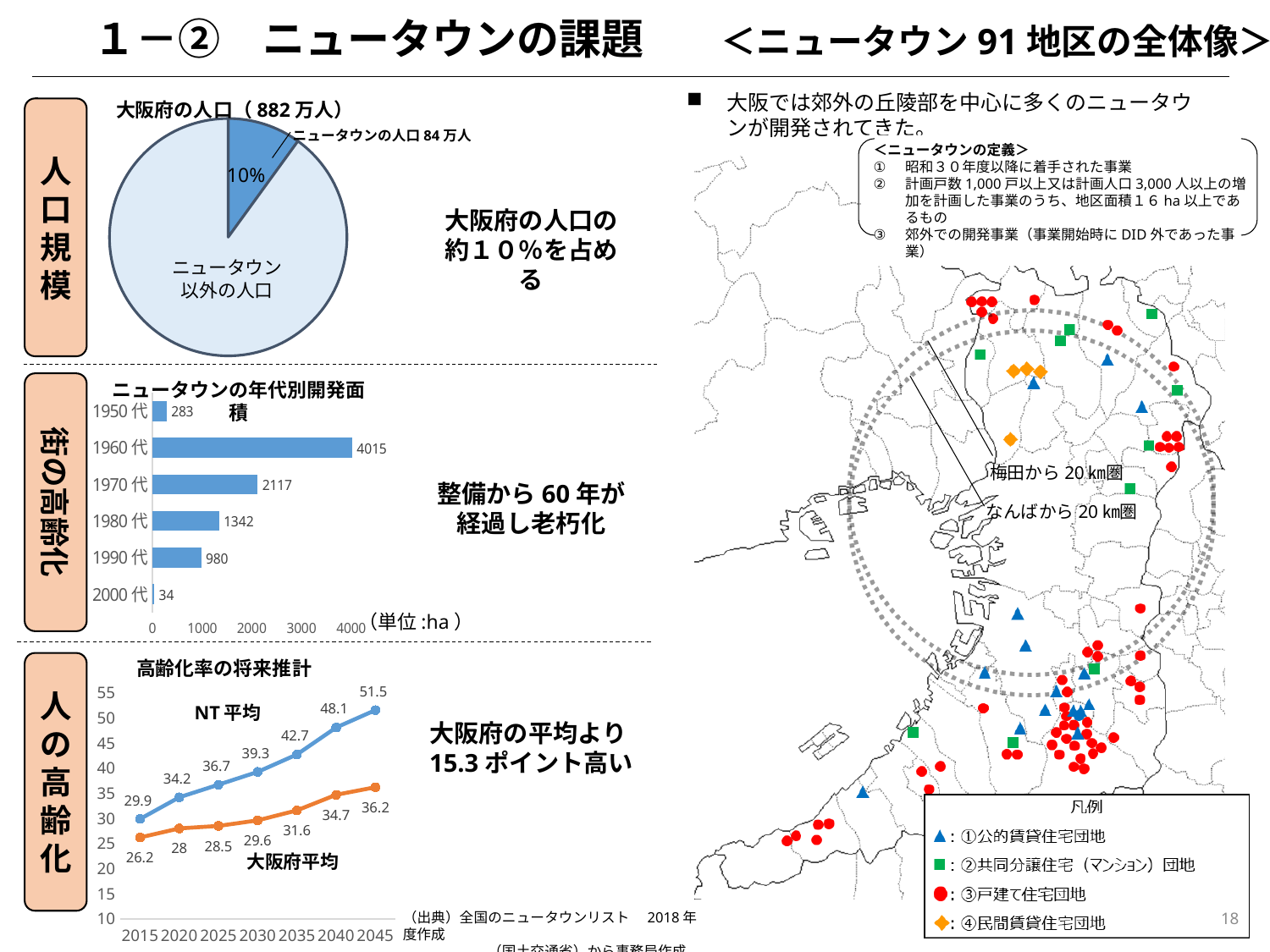
In the line chart 高齢化率の将来推計, which is larger in 2030, NT平均 or 大阪府平均? NT平均 In the bar chart ニュータウンの年代別開発面積, which decade has the highest value? 1960代 In the bar chart ニュータウンの年代別開発面積, what is the difference between the values for 1960代 and 1970代? 1898 In the pie chart 大阪府の人口, what share of the pie does ニュータウンの人口 take? 10% In the line chart 高齢化率の将来推計, do the values of 大阪府平均 rise or fall from 2015 to 2045? rise How many decade categories are shown in the bar chart ニュータウンの年代別開発面積? 6 In the bar chart ニュータウンの年代別開発面積, what is the value for 1960代? 4015 In the bar chart ニュータウンの年代別開発面積, which decade has the lowest value? 2000代 What kind of chart is ニュータウンの年代別開発面積? bar chart In the line chart 高齢化率の将来推計, what is the value of NT平均 in 2045? 51.5 What kind of chart is the 大阪府の人口 chart at the top left? pie chart In the line chart 高齢化率の将来推計, what is the difference between NT平均 and 大阪府平均 in 2045? 15.3